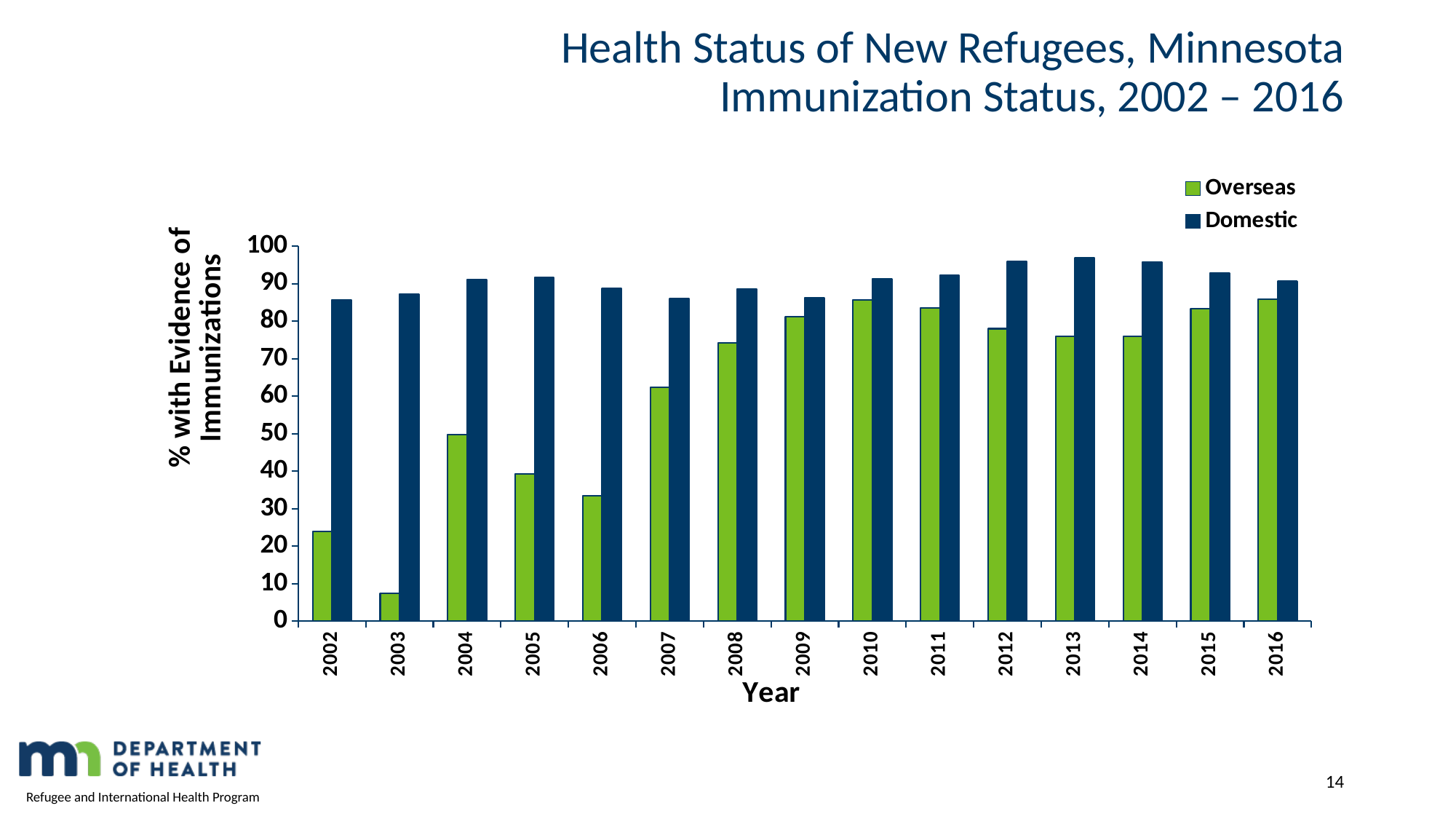
Is the Overseas value for 2007 greater or less than 60? greater How many years are shown on the x axis? 15 Is the Domestic value for 2012 greater or less than 90? greater Which year has the lowest Overseas value? 2003 What is the label of the y axis? % with Evidence of Immunizations Is the Overseas value for 2003 greater or less than 10? less In 2002, which is larger, the Overseas value or the Domestic value? Domestic Which is larger, the Overseas value for 2005 or the Overseas value for 2006? 2005 Do the Overseas values rise or fall from 2006 to 2010? rise What kind of chart is shown on the slide? bar chart How many series does the legend list? 2